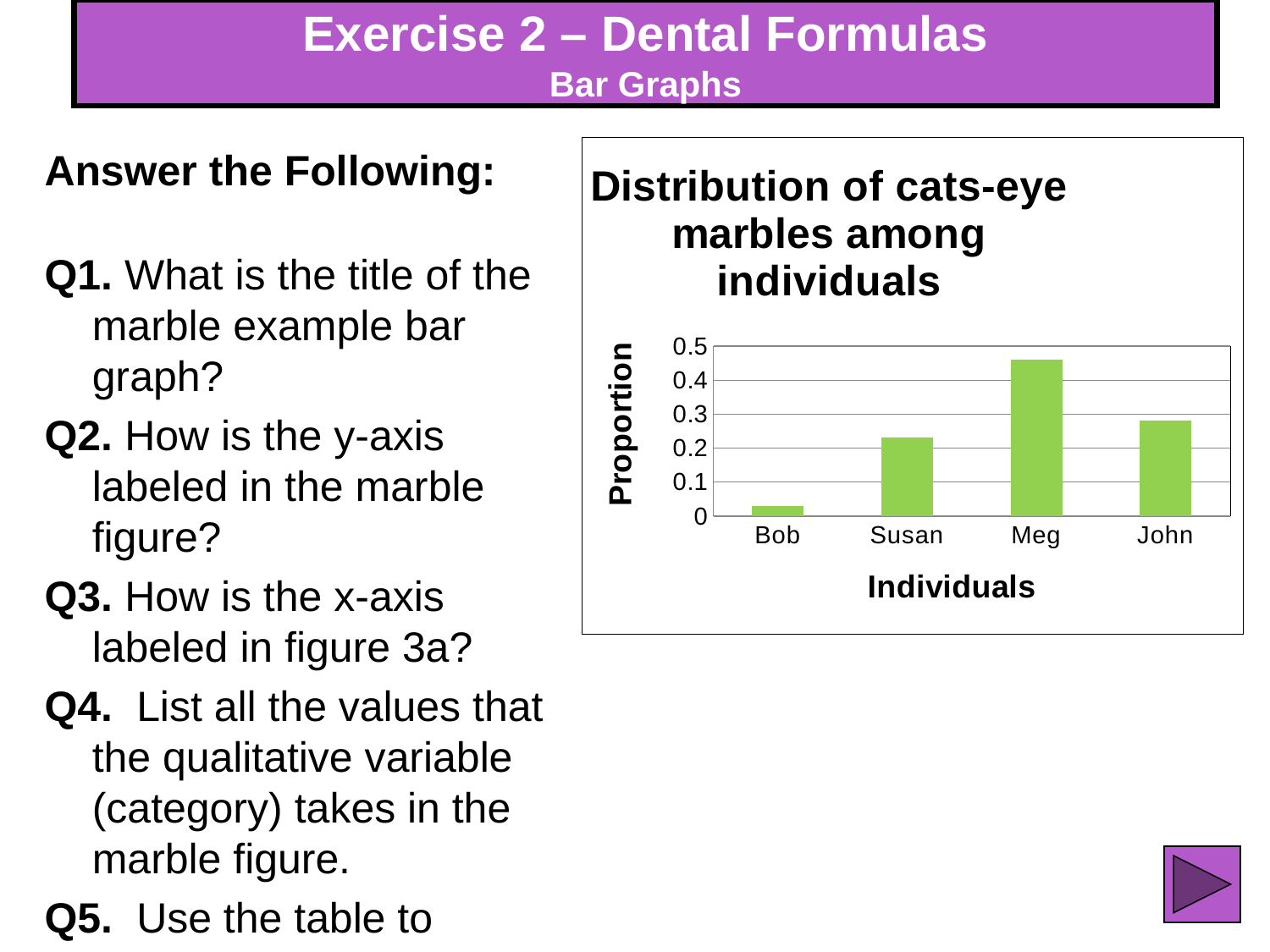
Who has a larger proportion of cats-eye marbles, Meg or Susan? Meg Which individual has the highest proportion of cats-eye marbles? Meg What kind of chart is shown on the slide? bar chart Which individual has the lowest proportion of cats-eye marbles? Bob Is the proportion for Susan greater or less than 0.3? less Who has a larger proportion of cats-eye marbles, John or Bob? John How many individuals are shown on the x-axis of the chart? 4 What is the title of the chart on the slide? Distribution of cats-eye marbles among individuals Is the proportion for Meg greater or less than 0.4? greater Is the proportion for John greater or less than 0.2? greater How is the y-axis of the chart labeled? Proportion